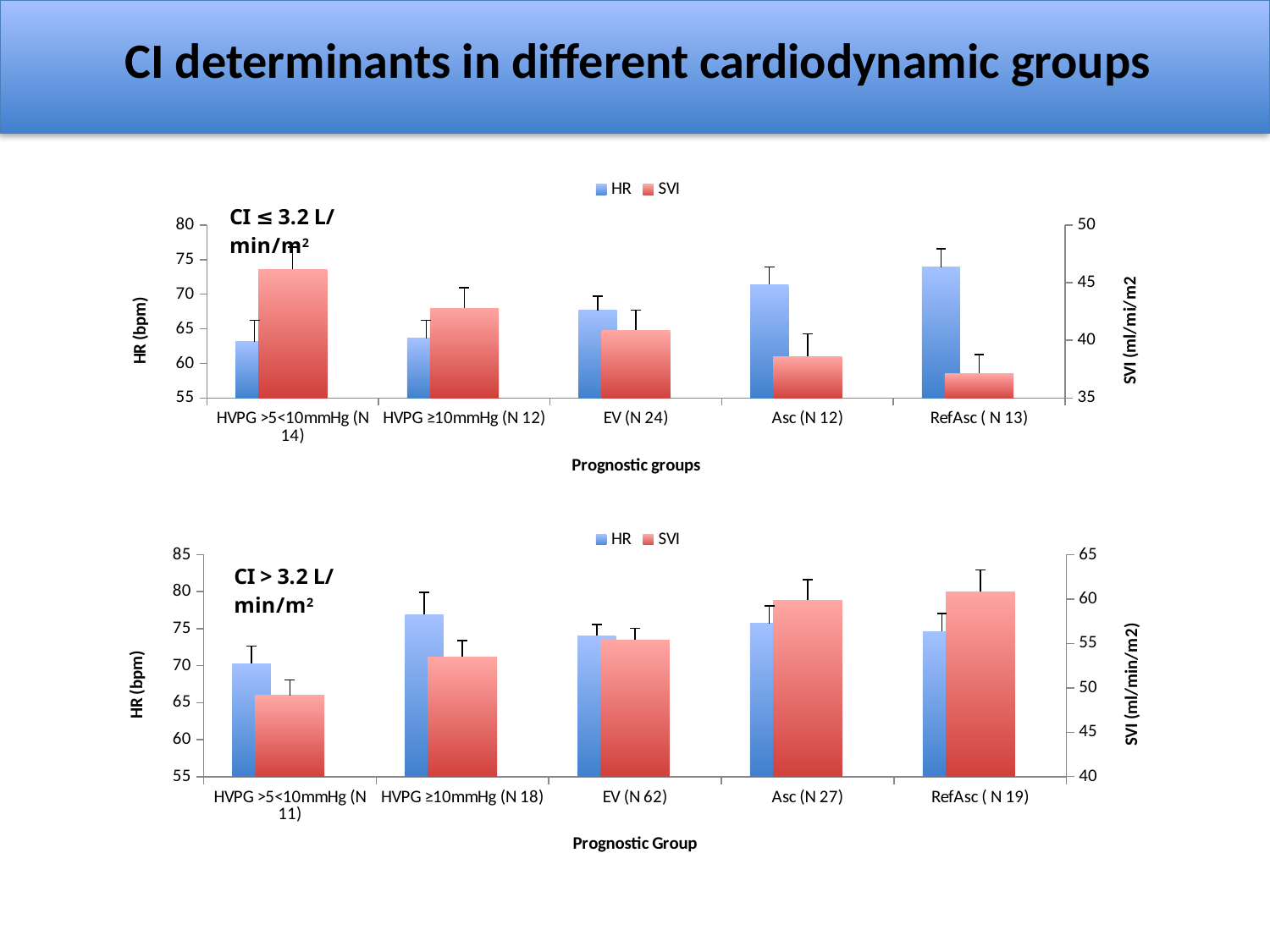
What kind of chart is the top chart (CI ≤ 3.2 L/min/m²)? bar chart In the bottom chart (CI > 3.2 L/min/m²), how many series does the legend list? 2 In the bottom chart (CI > 3.2 L/min/m²), which prognostic group has the lowest SVI? HVPG >5<10mmHg (N 11) What is the title of the right-hand vertical axis in the bottom chart (CI > 3.2 L/min/m²)? SVI (ml/min/m2) In the top chart (CI ≤ 3.2 L/min/m²), which prognostic group has the highest HR? RefAsc ( N 13) In the top chart (CI ≤ 3.2 L/min/m²), is the HR value for RefAsc ( N 13) greater or less than 70? greater In the top chart (CI ≤ 3.2 L/min/m²), which prognostic group has the highest SVI? HVPG >5<10mmHg (N 14) In the top chart (CI ≤ 3.2 L/min/m²), how many prognostic groups are shown on the x axis? 5 In the bottom chart (CI > 3.2 L/min/m²), is the HR value for HVPG >5<10mmHg (N 11) greater or less than 75? less In the top chart (CI ≤ 3.2 L/min/m²), is the SVI value for RefAsc ( N 13) greater or less than 40? less In the top chart (CI ≤ 3.2 L/min/m²), do the SVI values rise or fall from left to right across the prognostic groups? fall In the bottom chart (CI > 3.2 L/min/m²), do the SVI values rise or fall from left to right across the prognostic groups? rise